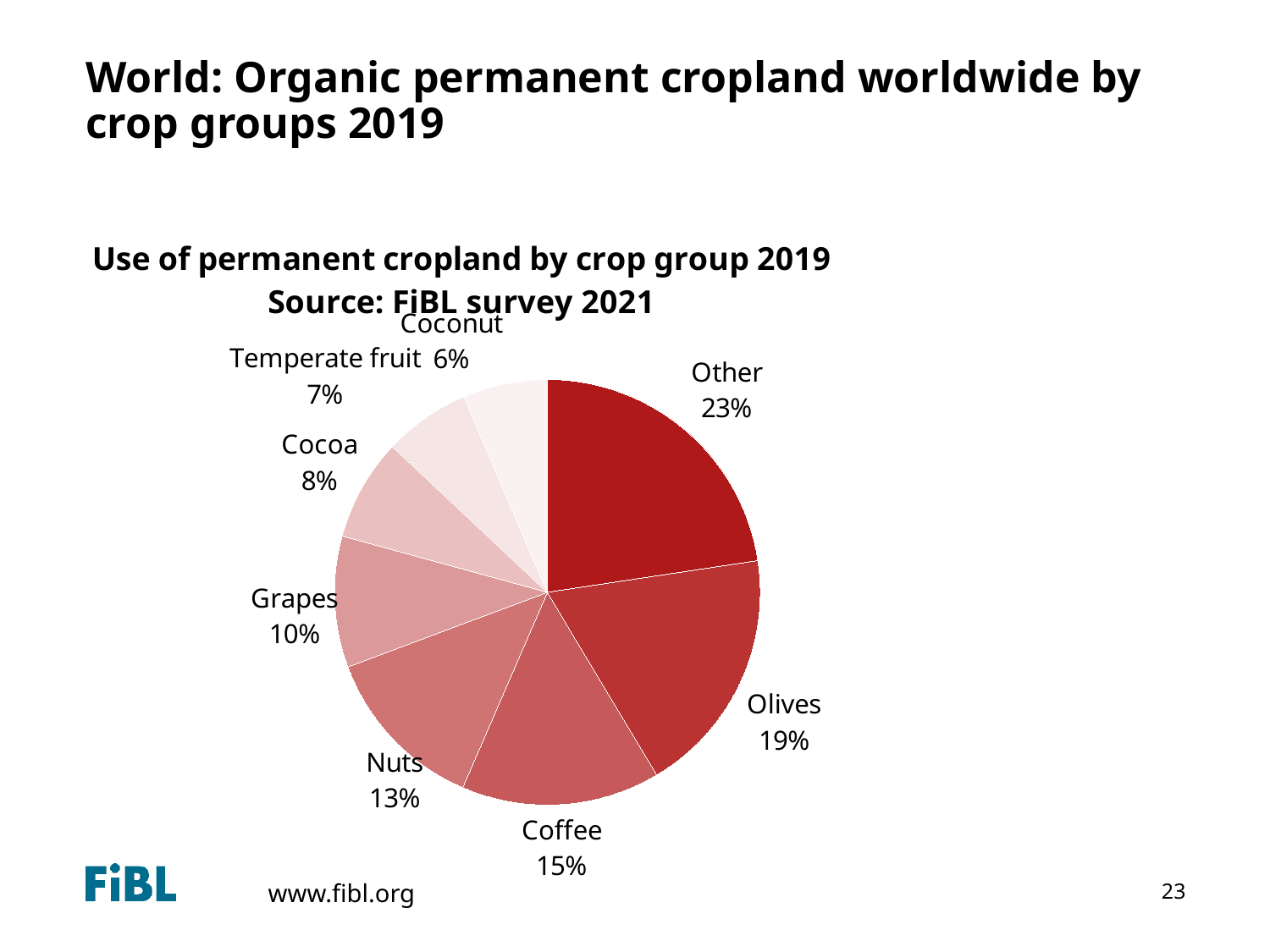
What source is cited in the chart title? FiBL survey 2021 Which crop group has the largest share of the pie? Other What share of organic permanent cropland is used for cocoa? 8% Which crop group has the smallest share of the pie? Coconut What share of organic permanent cropland is used for olives? 19% How many slices does the pie chart have? 8 What kind of chart is shown on the slide? pie chart Which has a larger share, temperate fruit or cocoa? Cocoa What is the difference in percentage points between the shares for olives and grapes? 9 What share of organic permanent cropland is used for coffee? 15% What share of organic permanent cropland is used for nuts? 13% What is the combined share of coffee and nuts? 28%